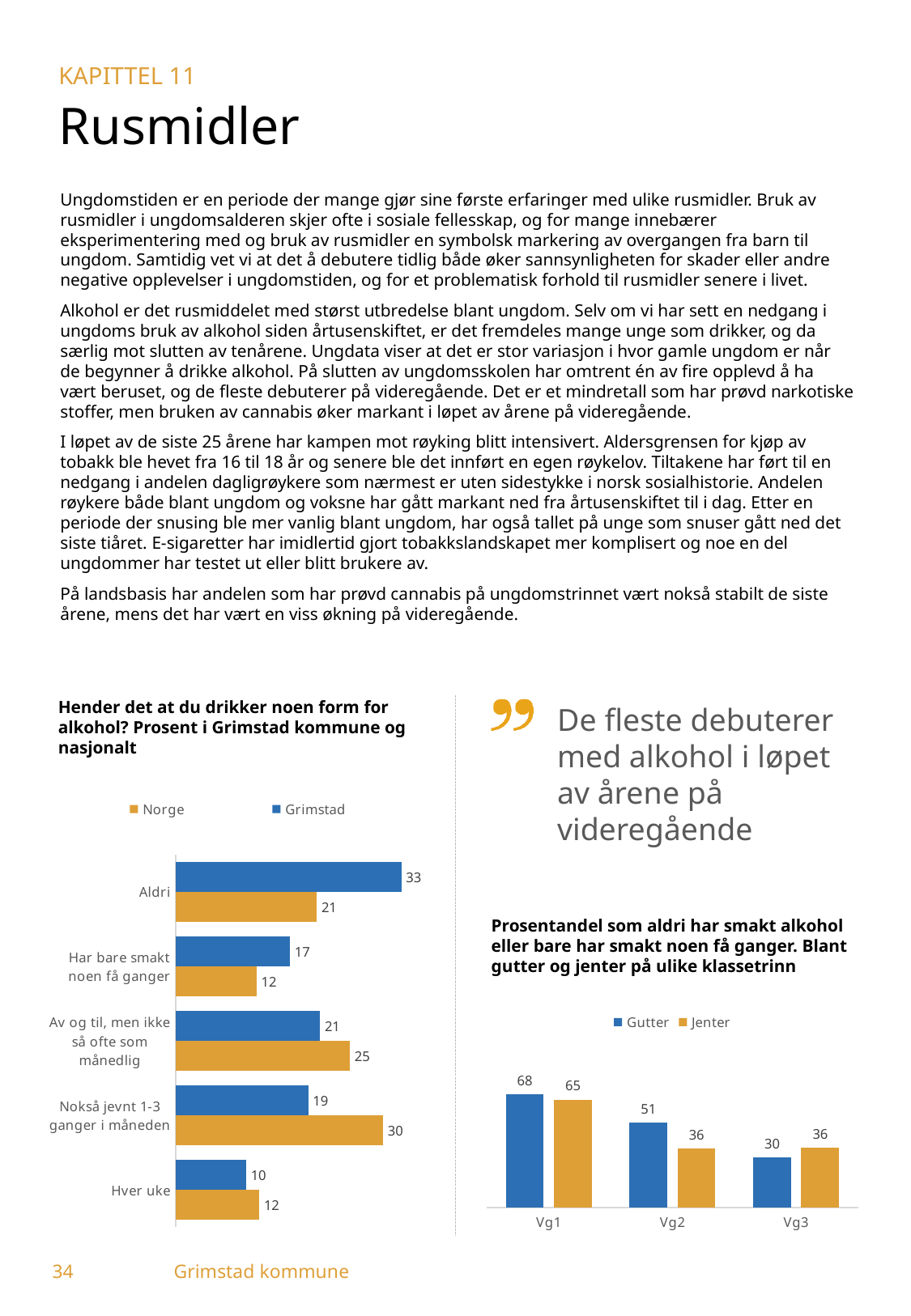
In the chart 'Hender det at du drikker noen form for alkohol?', what is the difference between the Grimstad and Norge values for 'Aldri'? 12 In the chart 'Hender det at du drikker noen form for alkohol?', what is the Grimstad value for 'Aldri'? 33 In the chart 'Hender det at du drikker noen form for alkohol?', what is the Norge value for 'Nokså jevnt 1-3 ganger i måneden'? 30 How many series does the legend list in the chart 'Prosentandel som aldri har smakt alkohol eller bare har smakt noen få ganger'? 2 In the chart 'Hender det at du drikker noen form for alkohol?', which is larger for 'Av og til, men ikke så ofte som månedlig': Norge or Grimstad? Norge In the chart 'Prosentandel som aldri har smakt alkohol eller bare har smakt noen få ganger', do the Gutter values rise or fall from Vg1 to Vg3? Fall In the chart 'Prosentandel som aldri har smakt alkohol eller bare har smakt noen få ganger', which class level has the highest Jenter value? Vg1 In the chart 'Prosentandel som aldri har smakt alkohol eller bare har smakt noen få ganger', what is the Gutter value for Vg2? 51 How many categories are shown in the chart 'Hender det at du drikker noen form for alkohol?'? 5 In the chart 'Hender det at du drikker noen form for alkohol?', which category has the lowest Grimstad value? Hver uke In the chart 'Prosentandel som aldri har smakt alkohol eller bare har smakt noen få ganger', what is the difference between Gutter and Jenter for Vg2? 15 What type of chart is 'Hender det at du drikker noen form for alkohol?'? Bar chart